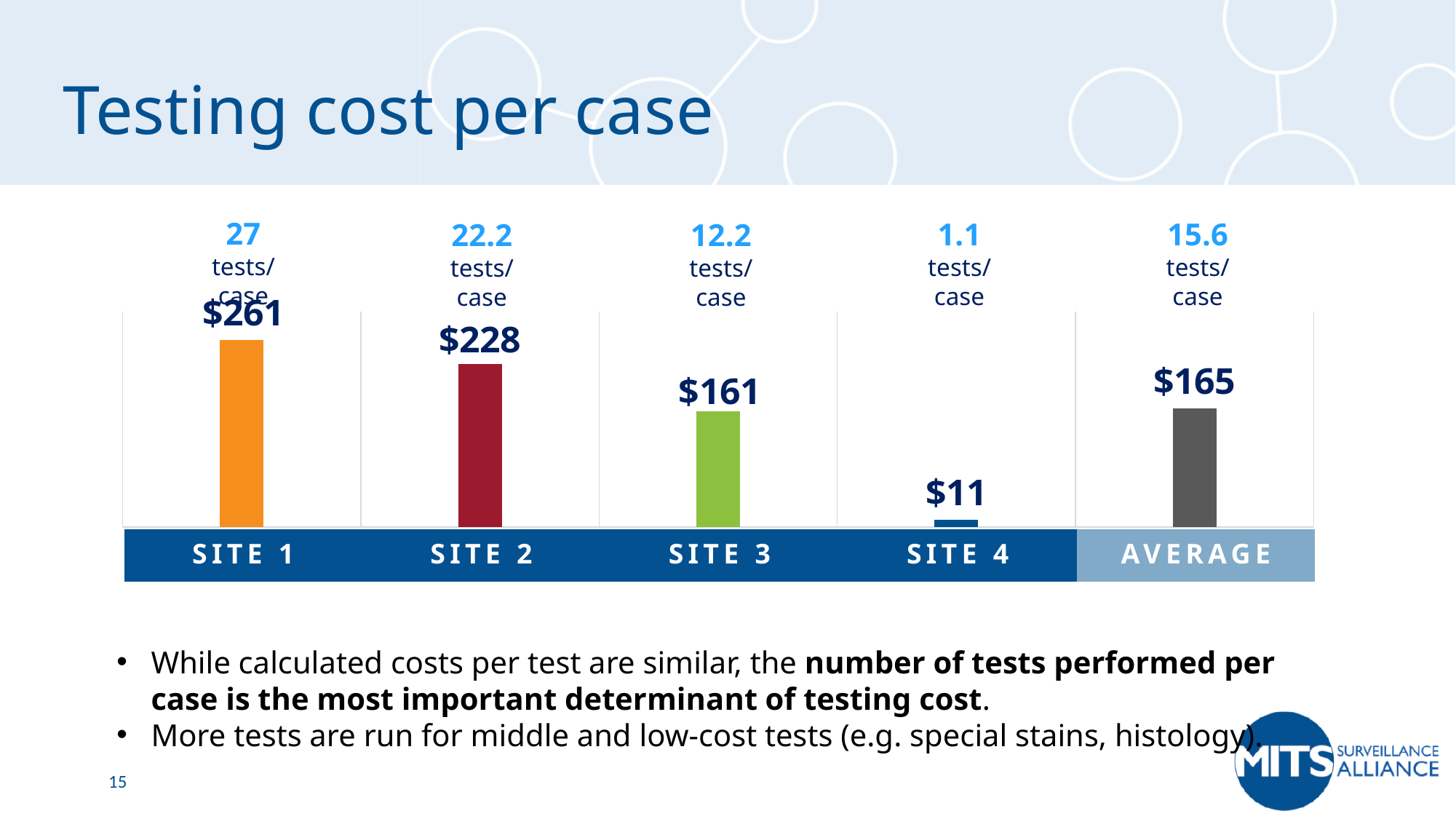
What kind of chart is shown on the slide? Bar chart What is the difference in testing cost per case between Site 1 and Site 2? $33 What is the difference in testing cost per case between Site 3 and Site 4? $150 What is the average testing cost per case shown on the chart? $165 How many tests per case are reported for Site 4? 1.1 Which site has the highest testing cost per case? Site 1 Which has a higher testing cost per case, Site 2 or Site 3? Site 2 Which site has the lowest testing cost per case? Site 4 What colour is the bar for Site 3? Green What is the testing cost per case for Site 1? $261 What is the testing cost per case for Site 3? $161 How many bars are shown on the chart? 5